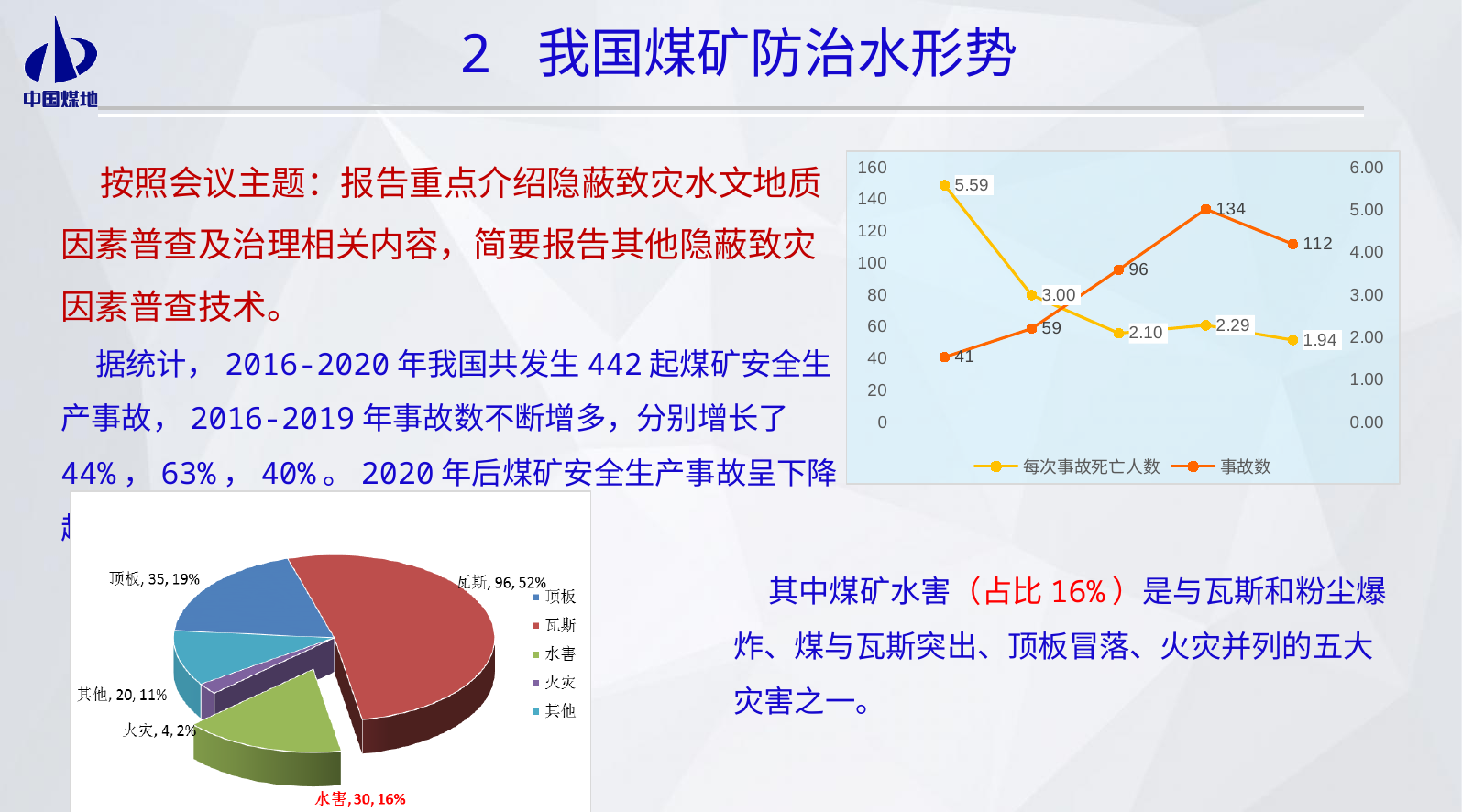
In the pie chart at the bottom left, what is the value for 瓦斯? 96 In the pie chart at the bottom left, what share of the pie does 水害 represent? 16% In the line chart at the top right, how many data points does the 事故数 series have? 5 In the line chart at the top right, what is the highest value of the 事故数 series? 134 In the pie chart at the bottom left, how many categories are shown? 5 In the pie chart at the bottom left, which category has the smallest slice? 火灾 In the line chart at the top right, what is the highest value of the 每次事故死亡人数 series? 5.59 In the line chart at the top right, what is the difference between the highest and lowest values of the 事故数 series? 93 In the line chart at the top right, what is the lowest value of the 每次事故死亡人数 series? 1.94 In the line chart at the top right, how many series does the legend list? 2 In the line chart at the top right, what is the lowest value of the 事故数 series? 41 In the pie chart at the bottom left, which is larger, 顶板 or 其他? 顶板